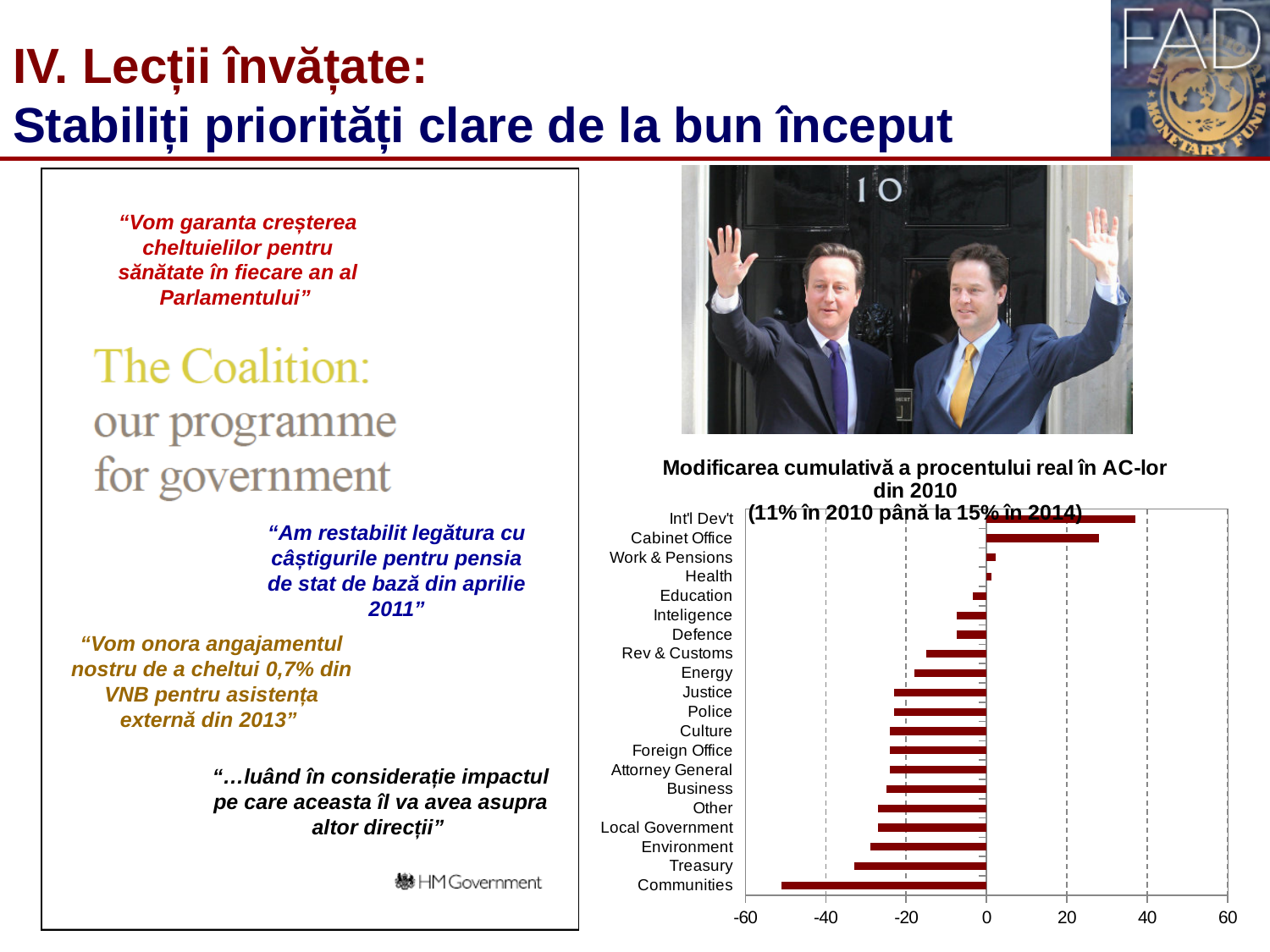
Is the value for Defence greater or less than -20? greater Is the value for Int'l Dev't greater or less than 20? greater Which has the lower value, Communities or Treasury? Communities What is the title of the chart? Modificarea cumulativă a procentului real în AC-lor din 2010 (11% în 2010 până la 15% în 2014) Which department has the highest value in the chart? Int'l Dev't How many departments have a positive value in the chart? 4 Which has the larger value, Int'l Dev't or Cabinet Office? Int'l Dev't How many categories (departments) are plotted in the chart? 20 Which department has the lowest value in the chart? Communities Is the value for Treasury greater or less than -20? less What kind of chart is shown on the slide? bar chart